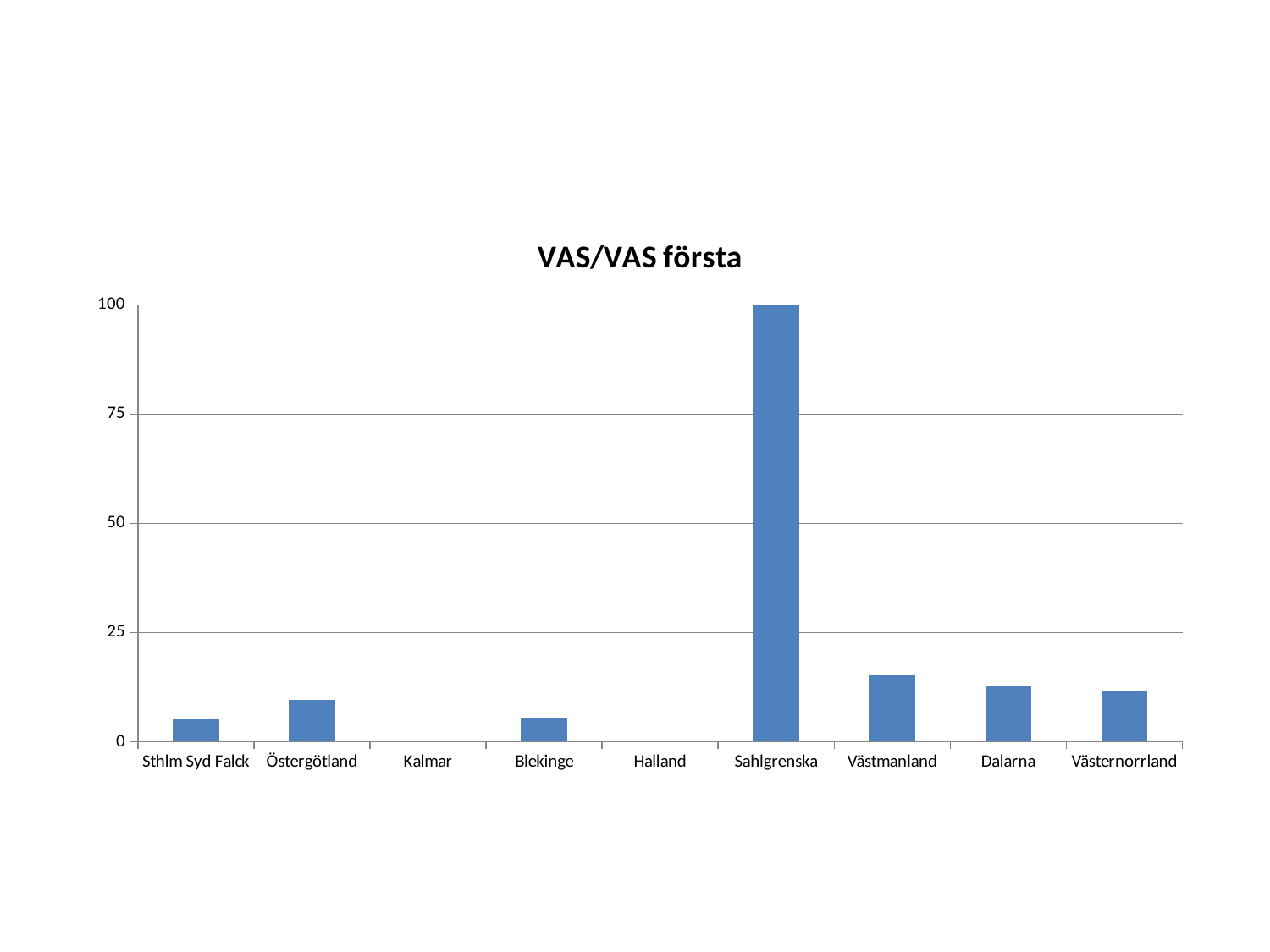
Which category has the highest value in the chart? Sahlgrenska Is the value for Östergötland greater or less than 25? less Which is larger, the value for Västmanland or the value for Sthlm Syd Falck? Västmanland What is the value for Sahlgrenska? 100 Is the value for Västmanland greater or less than 25? less How many categories are shown on the x axis of the chart? 9 Is the value for Sahlgrenska greater or less than 75? greater What is the value for Kalmar? 0 Which is larger, the value for Östergötland or the value for Blekinge? Östergötland What is the value for Halland? 0 What kind of chart is shown on the slide? bar chart What is the title of the chart? VAS/VAS första